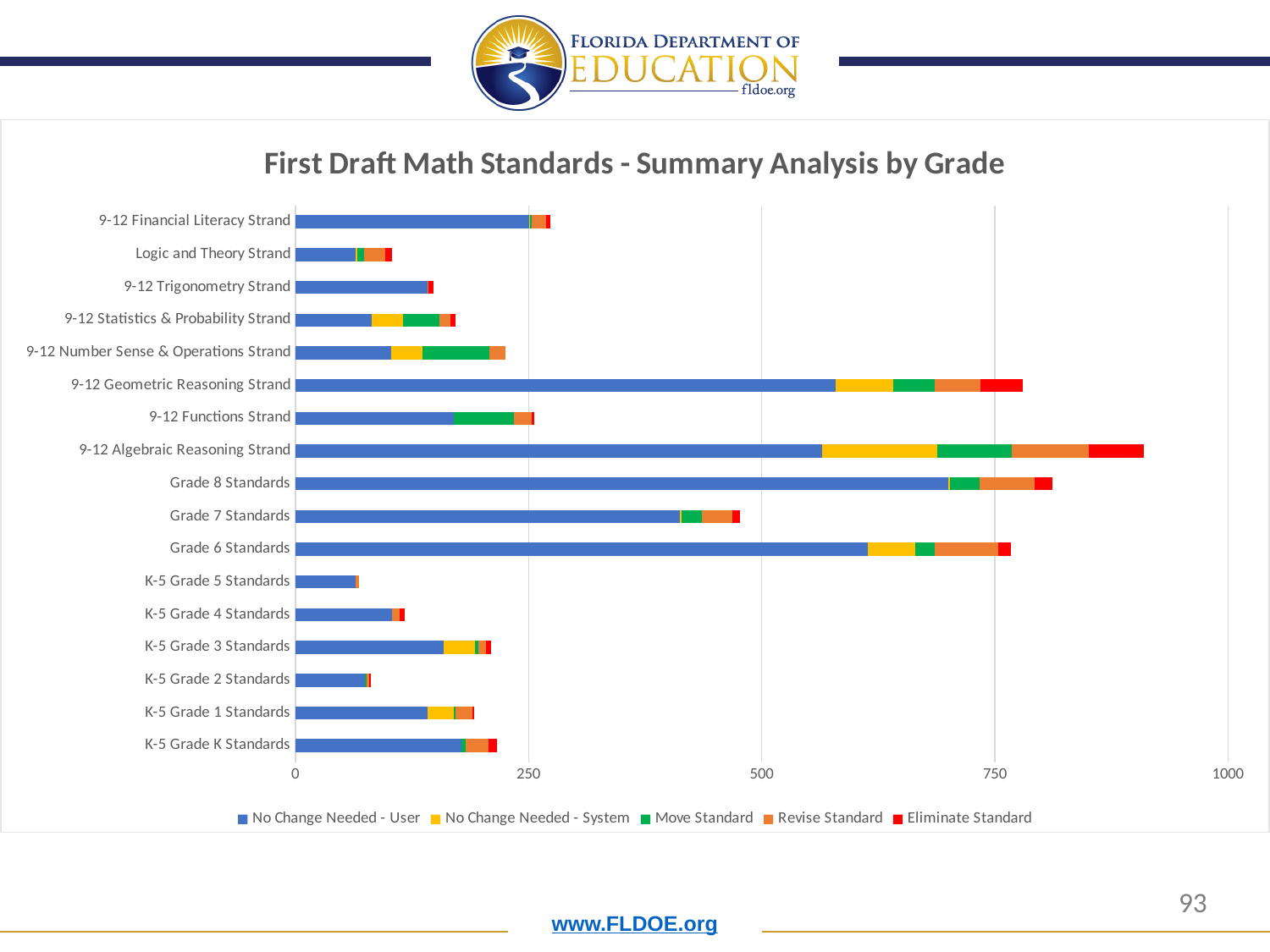
Is the total bar for 9-12 Financial Literacy Strand greater or less than 250? greater How many series does the legend list? 5 What kind of chart is shown on the slide? Stacked bar chart Which has the longer total bar, 9-12 Algebraic Reasoning Strand or 9-12 Geometric Reasoning Strand? 9-12 Algebraic Reasoning Strand Which series is shown in red in the legend? Eliminate Standard Is the total bar for Grade 7 Standards greater or less than 500? less How many categories (grade levels or strands) are plotted on the chart? 17 Which category has the longest total bar? 9-12 Algebraic Reasoning Strand Is the total bar for Grade 8 Standards greater or less than 750? greater Which has the longer total bar, Grade 8 Standards or Grade 7 Standards? Grade 8 Standards What is the title of the chart? First Draft Math Standards - Summary Analysis by Grade